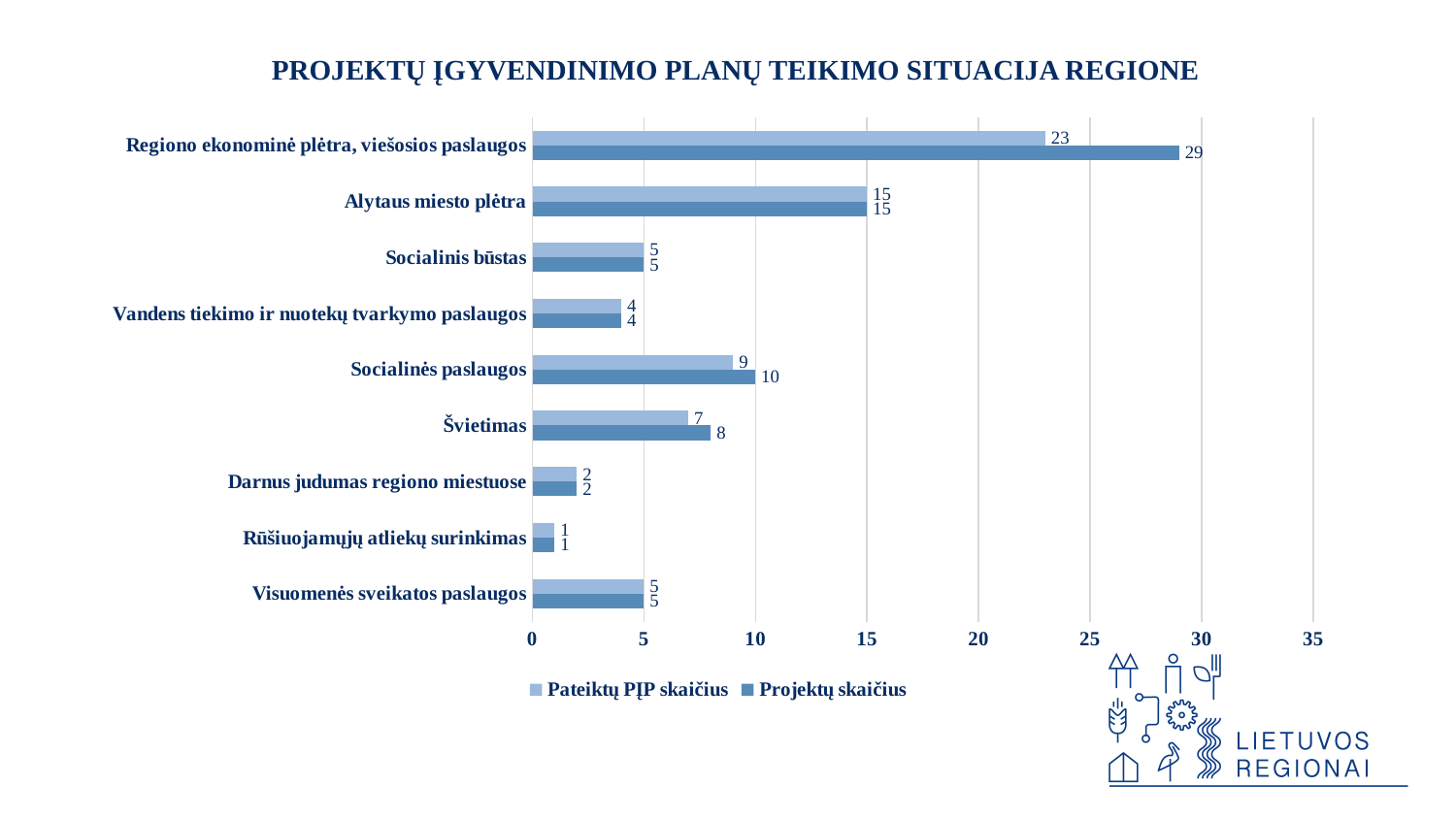
How many series does the legend list? 2 What is the value of Pateiktų PĮP skaičius for Socialinės paslaugos? 9 How many categories are shown on the chart? 9 Which is larger for Socialinės paslaugos: Pateiktų PĮP skaičius or Projektų skaičius? Projektų skaičius What is the value of Projektų skaičius for Švietimas? 8 What is the title of the chart? PROJEKTŲ ĮGYVENDINIMO PLANŲ TEIKIMO SITUACIJA REGIONE What kind of chart is shown on the slide? bar chart Which category has the highest Projektų skaičius? Regiono ekonominė plėtra, viešosios paslaugos Which category has the lowest Pateiktų PĮP skaičius? Rūšiuojamųjų atliekų surinkimas What is the difference between Projektų skaičius and Pateiktų PĮP skaičius for Regiono ekonominė plėtra, viešosios paslaugos? 6 What is the value of Projektų skaičius for Regiono ekonominė plėtra, viešosios paslaugos? 29 Is the Pateiktų PĮP skaičius value for Alytaus miesto plėtra greater or less than 10? greater